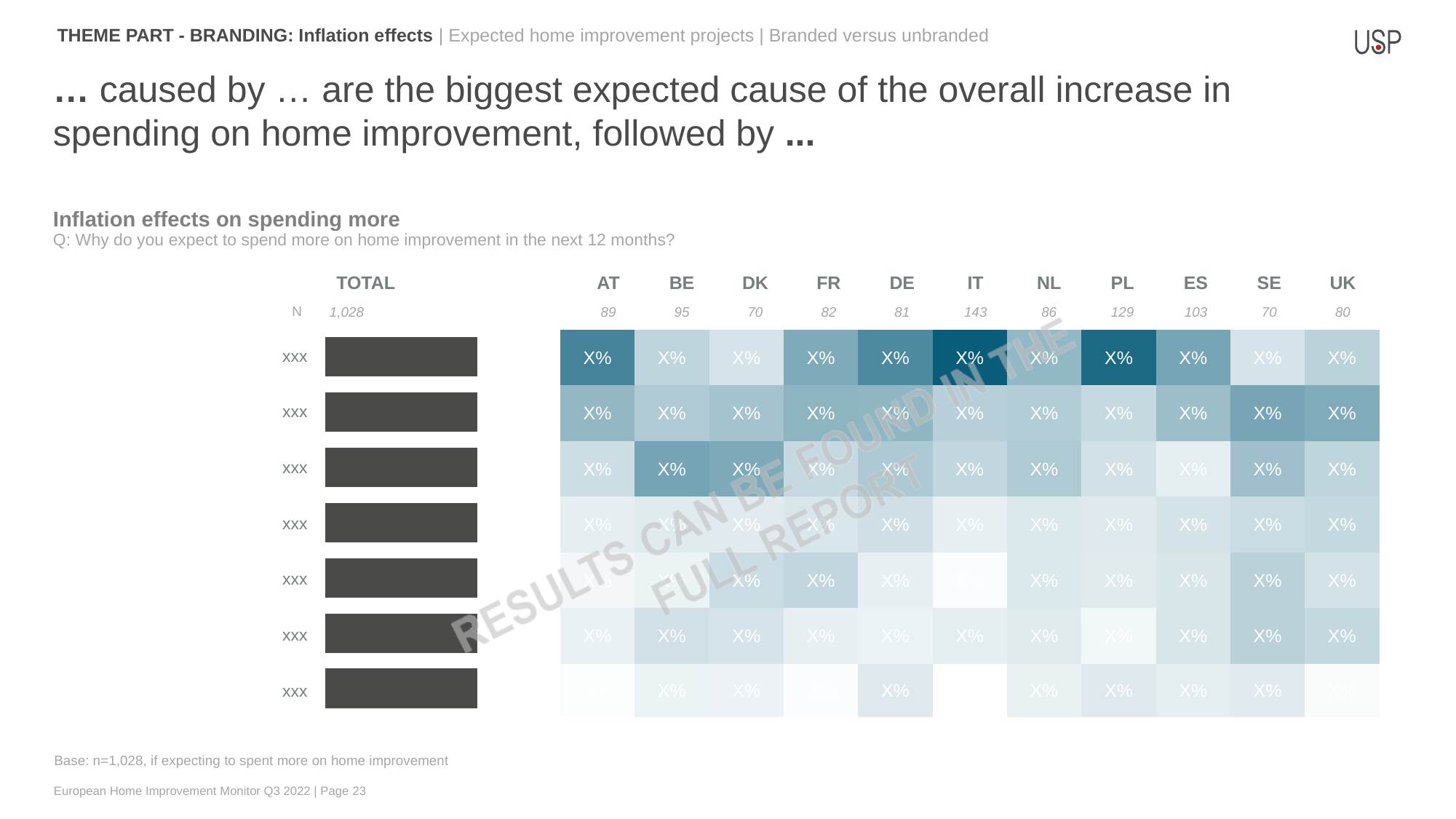
How many rows (reasons) are plotted in the chart? 7 What is the N (sample size) shown for DK? 70 Which country column has the highest N (sample size)? IT What is the N (sample size) shown for IT? 143 How many country columns (excluding TOTAL) are shown in the chart? 11 What is the difference between the N for IT and the N for PL? 14 What is the N (sample size) shown for PL? 129 What is the title of the chart on the slide? Inflation effects on spending more What kind of chart is shown in the TOTAL column of the chart? bar chart What is the N (sample size) shown for the TOTAL column? 1,028 Which country column appears last (rightmost) in the chart? UK Which has a larger N, PL or ES? PL